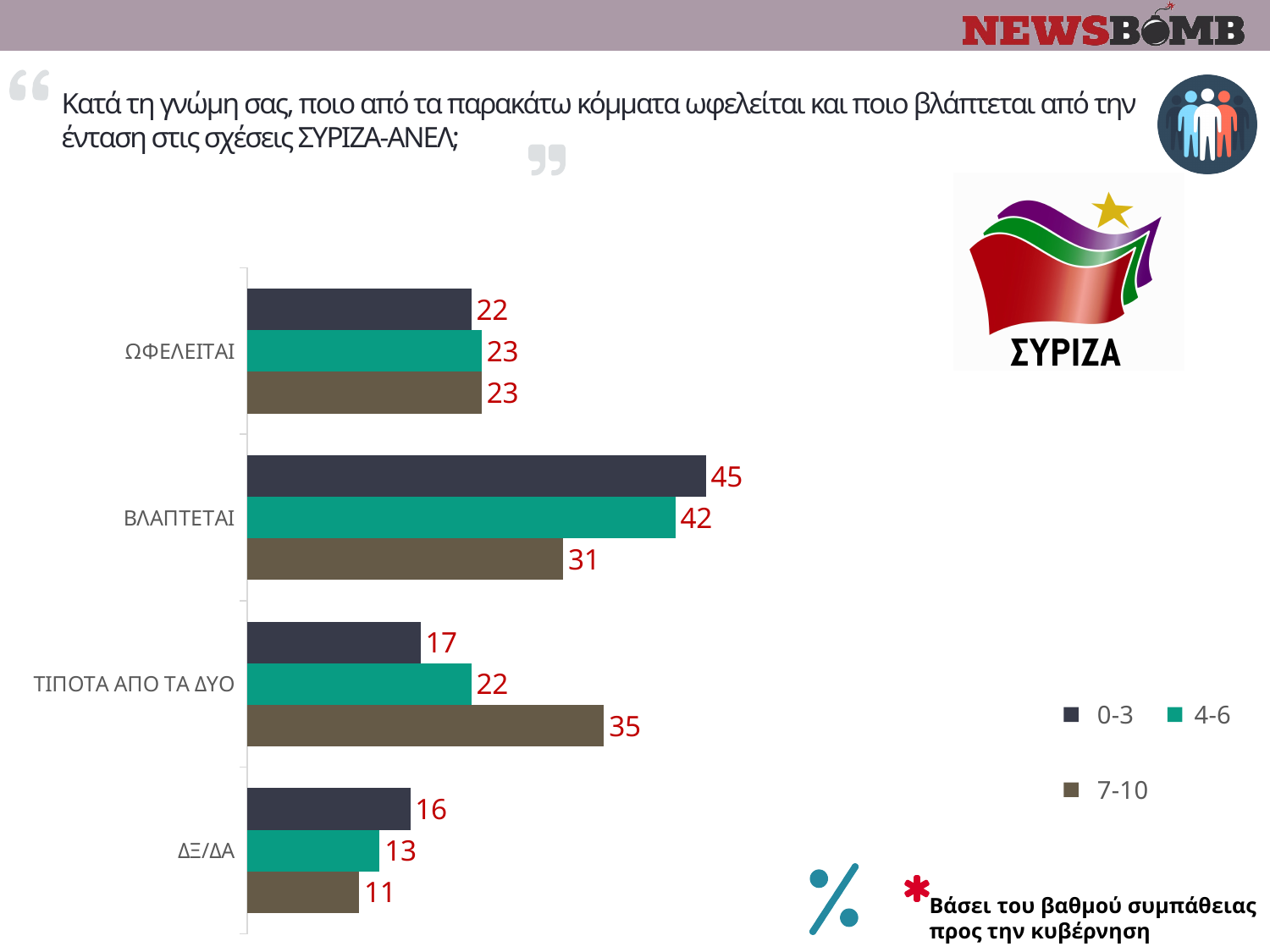
Which category has the highest value in the 4-6 series? ΒΛΑΠΤΕΤΑΙ Which series is shown in green in the legend? 4-6 How many series does the legend list? 3 What is the value for ΔΞ/ΔΑ in the 4-6 series? 13 For ΤΙΠΟΤΑ ΑΠΟ ΤΑ ΔΥΟ, which series has the larger value, 0-3 or 7-10? 7-10 Which category has the lowest value in the 7-10 series? ΔΞ/ΔΑ What is the difference between the 0-3 and 7-10 values for ΒΛΑΠΤΕΤΑΙ? 14 What is the value for ΤΙΠΟΤΑ ΑΠΟ ΤΑ ΔΥΟ in the 7-10 series? 35 What is the value for ΩΦΕΛΕΙΤΑΙ in the 0-3 series? 22 What is the value for ΒΛΑΠΤΕΤΑΙ in the 0-3 series? 45 What kind of chart is shown on the slide? Bar chart How many categories are shown on the chart? 4